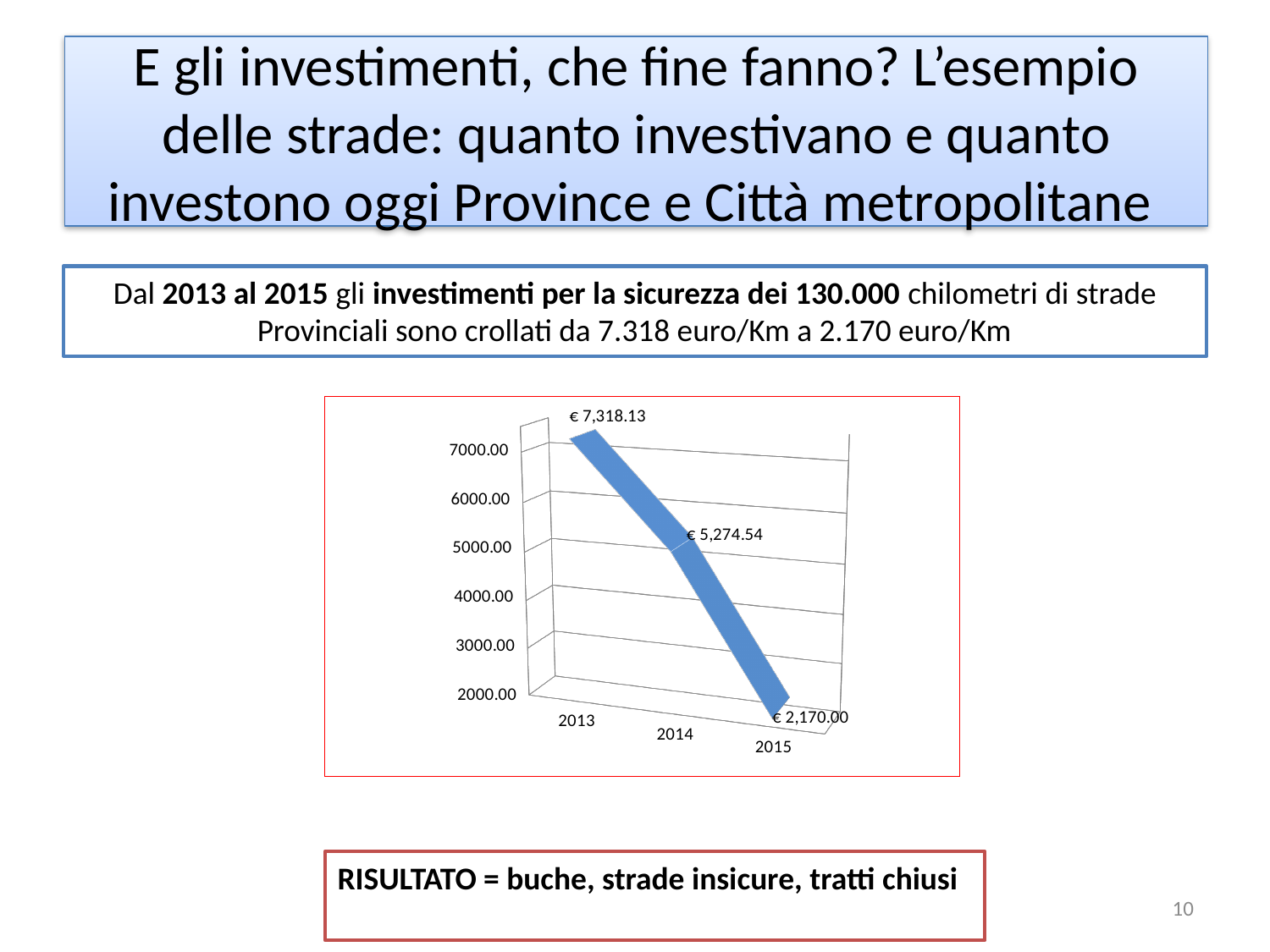
How many years are plotted on the chart? 3 Which year has the highest value? 2013 What is the value plotted for 2013? € 7,318.13 What is the difference between the values for 2014 and 2015? € 3,104.54 Which year has the lowest value? 2015 What is the difference between the values for 2013 and 2015? € 5,148.13 What is the difference between the values for 2013 and 2014? € 2,043.59 Which year has a larger value, 2014 or 2015? 2014 What kind of chart is shown on the slide? line chart What is the value plotted for 2014? € 5,274.54 Do the values rise or fall from 2013 to 2015? fall What is the value plotted for 2015? € 2,170.00